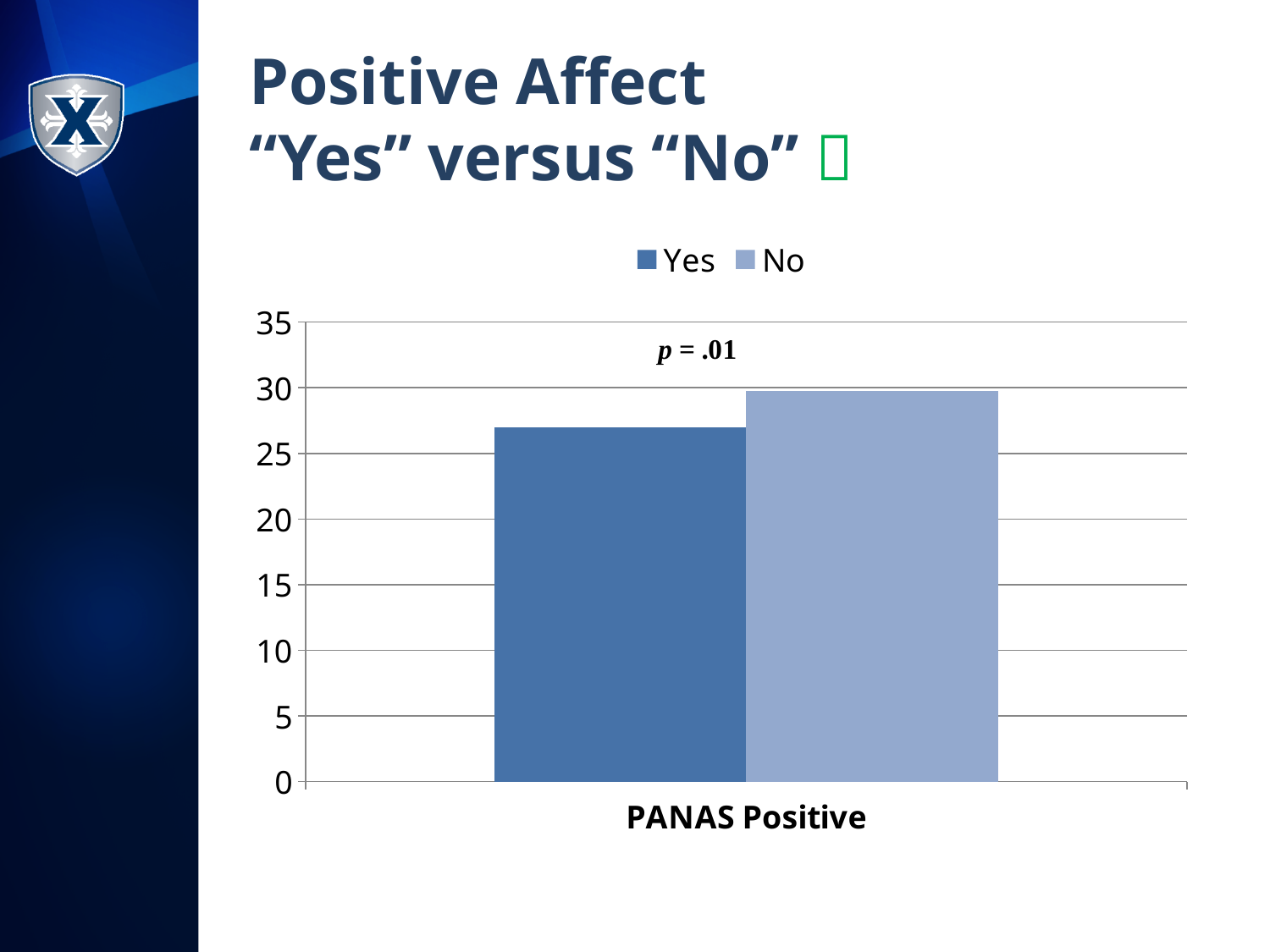
What are the two entries in the chart legend? Yes and No Which series has the taller bar for PANAS Positive, Yes or No? No What p value is annotated on the chart? p = .01 Which series has the lowest bar in the chart? Yes How many categories are shown on the x axis of the chart? 1 Is the value for No on PANAS Positive greater or less than 25? greater Is the value for Yes on PANAS Positive greater or less than 25? greater What kind of chart is shown on the slide? bar chart Which series has the highest bar in the chart? No How many series does the chart legend list? 2 Is the value for Yes on PANAS Positive greater or less than 30? less